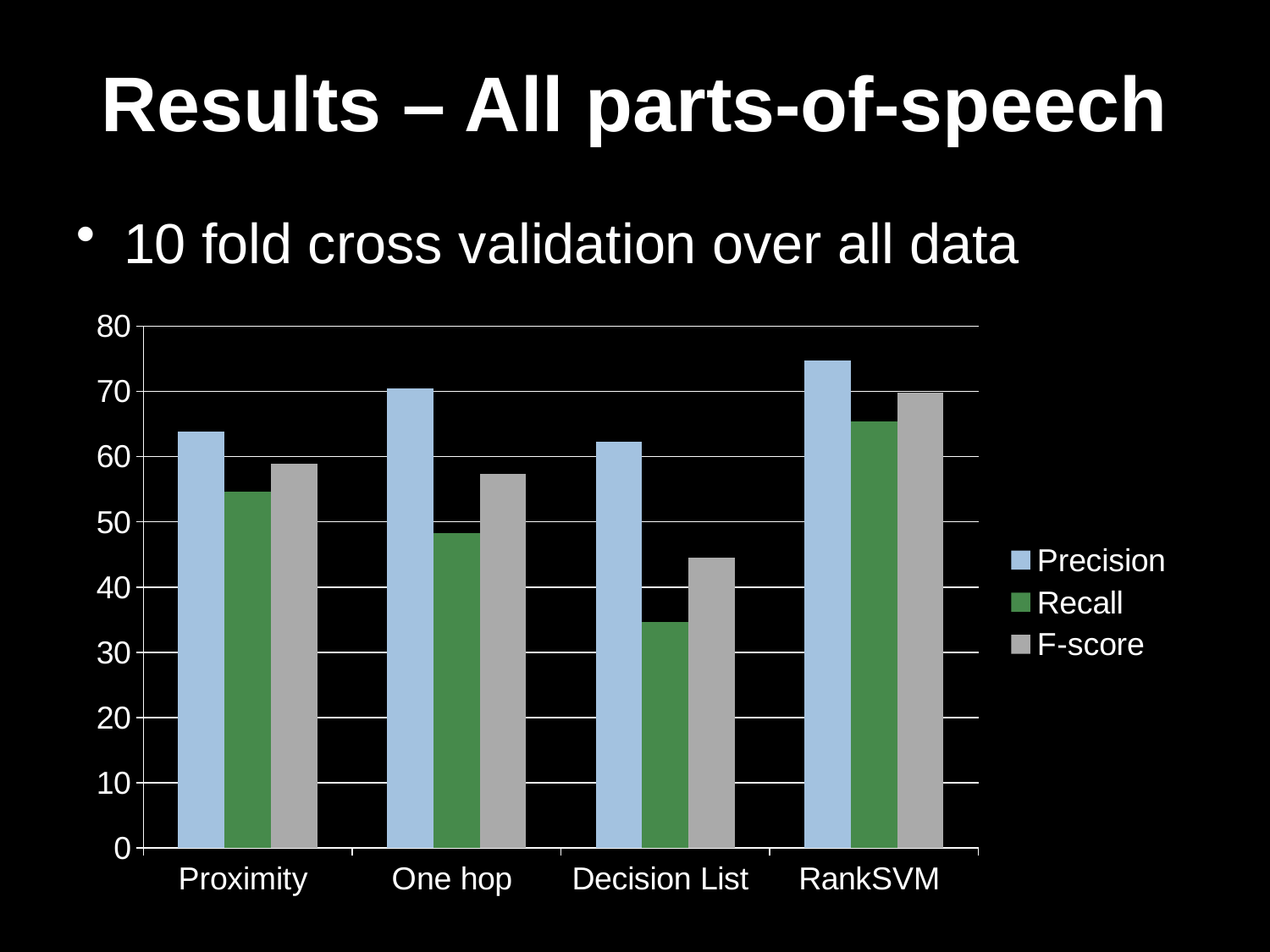
How many series does the legend list? 3 What kind of chart is shown on the slide? bar chart Which category has the lowest F-score? Decision List Which category has the highest F-score? RankSVM Is the F-score value for Decision List greater or less than 50? less Which is larger, the Precision for One hop or the Precision for Proximity? One hop Is the Precision value for RankSVM greater or less than 70? greater Which category has the highest Precision? RankSVM Is the Recall value for Decision List greater or less than 40? less Which category has the lowest Recall? Decision List How many categories are shown on the x axis? 4 Which series is shown in green in the legend? Recall